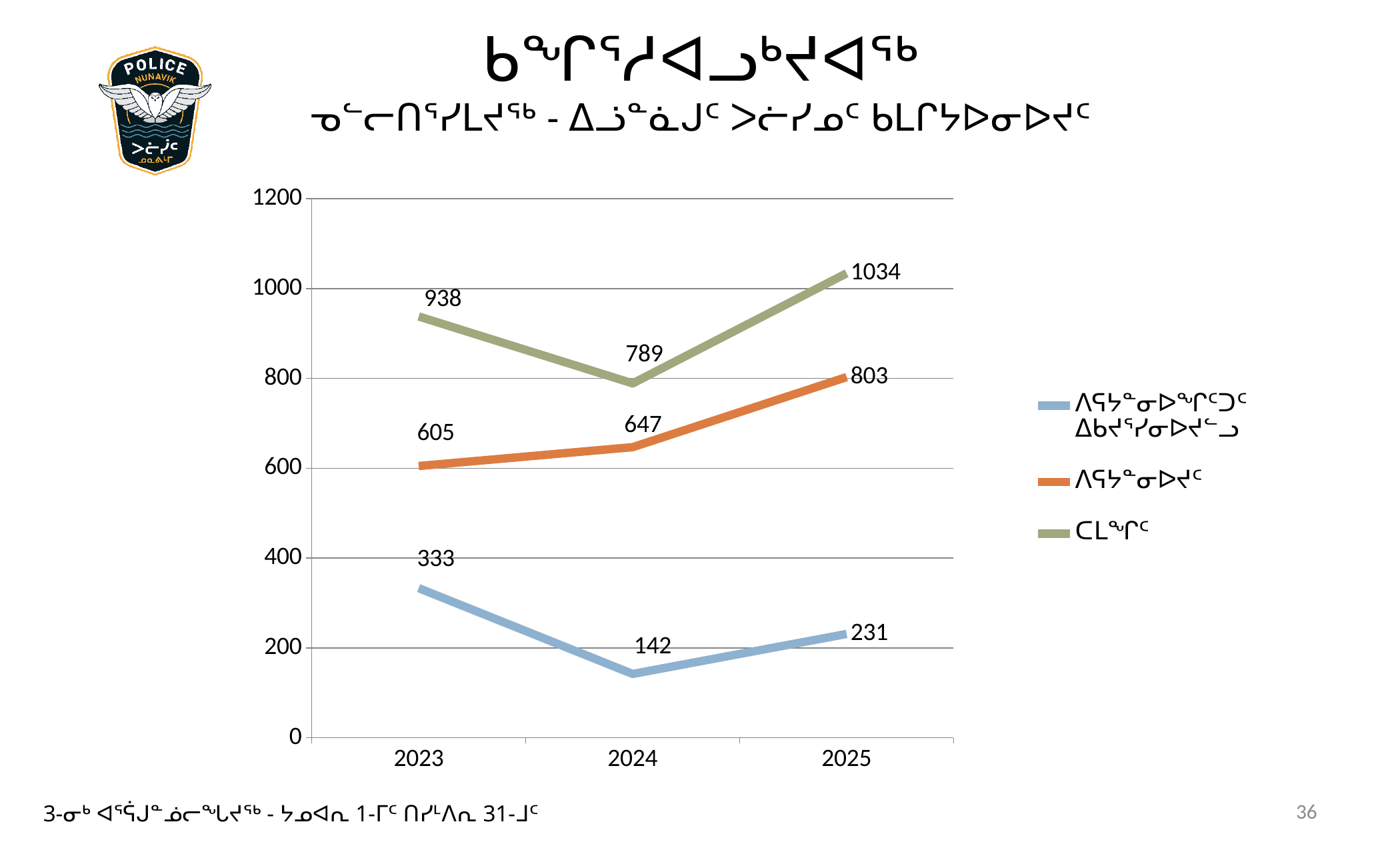
In which year does the blue series have its lowest value? 2024 In which year does the green series reach its highest value? 2025 By how much did the orange series increase from 2023 to 2025? 198 What is the value of the orange series in 2025? 803 Does the orange series rise or fall from 2023 to 2025? Rise What is the difference between the green series values in 2025 and 2024? 245 What is the value of the green series in 2023? 938 For the blue series, which year has the larger value, 2023 or 2025? 2023 What kind of chart is shown on the slide? Line chart How many series does the legend list? 3 What is the value of the blue series in 2024? 142 How many years are shown on the x axis? 3